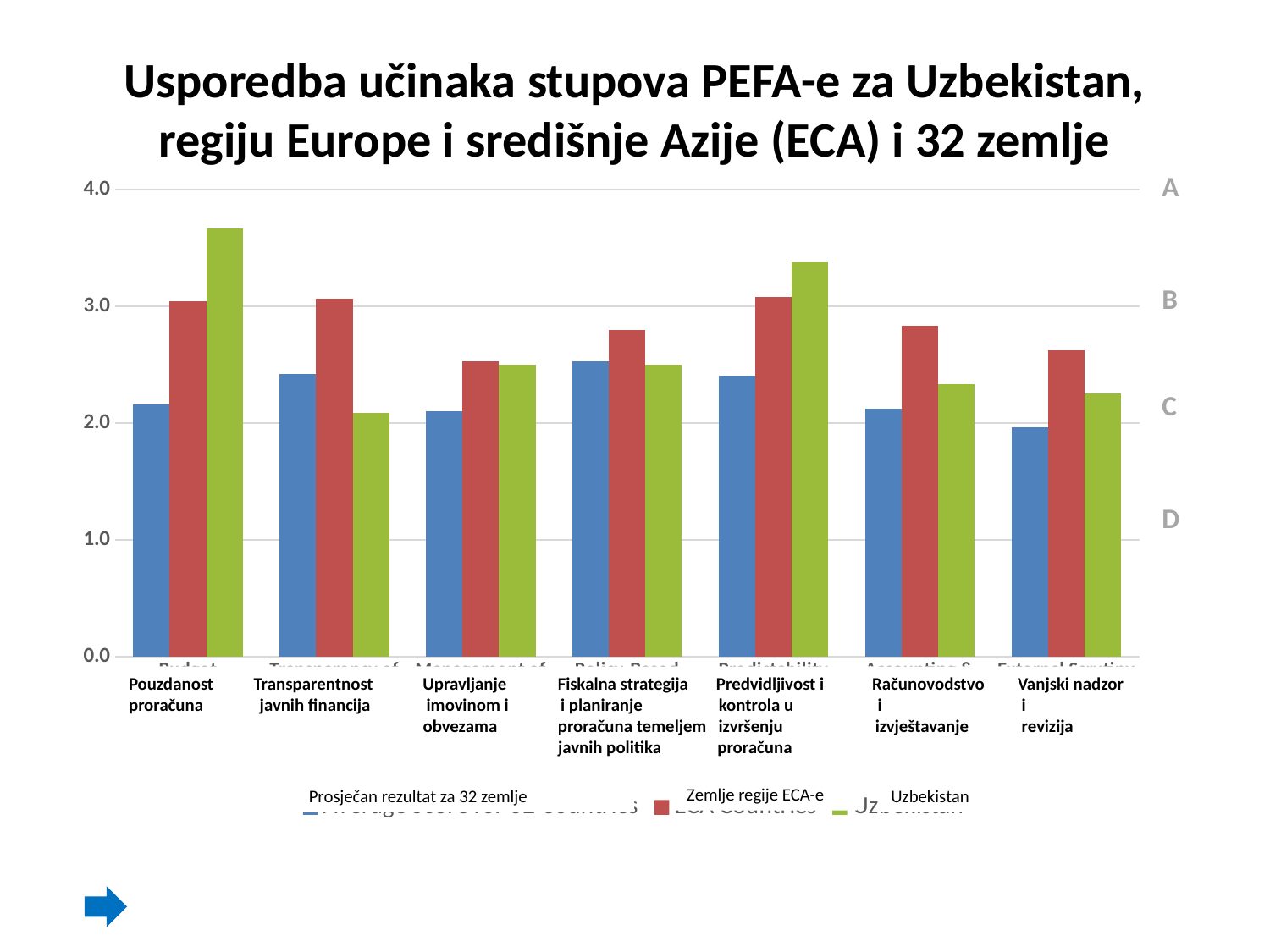
How many categories (PEFA pillars) are shown on the x axis? 7 Which colour represents the Uzbekistan series in the chart? green How many series does the legend list? 3 For which category is the value for Prosječan rezultat za 32 zemlje lowest? Vanjski nadzor i revizija Is the Uzbekistan value for Predvidljivost i kontrola u izvršenju proračuna greater or less than 3.0? greater Is the Uzbekistan value for Pouzdanost proračuna greater or less than 3.0? greater For which category is the Uzbekistan value highest? Pouzdanost proračuna What kind of chart is shown on the slide? bar chart For Pouzdanost proračuna, which is larger: the value for Uzbekistan or for Prosječan rezultat za 32 zemlje? Uzbekistan For Transparentnost javnih financija, which is larger: the value for Zemlje regije ECA-e or for Uzbekistan? Zemlje regije ECA-e Is the Zemlje regije ECA-e value for Fiskalna strategija i planiranje proračuna temeljem javnih politika greater or less than 3.0? less